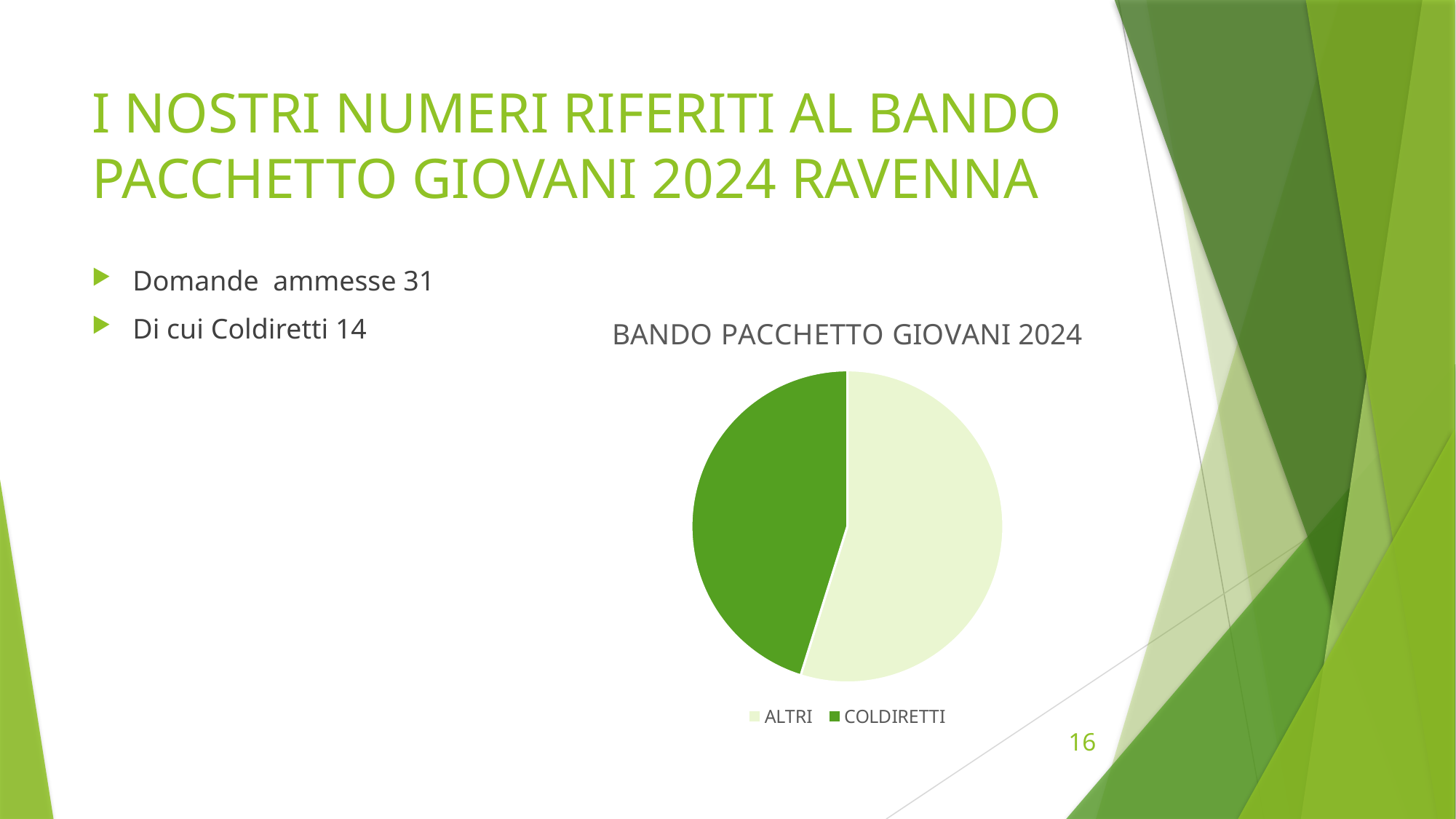
What colour is the COLDIRETTI slice in the pie chart? dark green Which slice of the pie chart is the smallest? COLDIRETTI Which slice of the pie chart is the largest? ALTRI How many entries does the legend of the pie chart list? 2 What kind of chart is shown on the slide? pie chart According to the slide, how many of the admitted applications are from Coldiretti? 14 What is the title of the pie chart? BANDO PACCHETTO GIOVANI 2024 Which slice is larger in the pie chart, ALTRI or COLDIRETTI? ALTRI How many slices does the pie chart have? 2